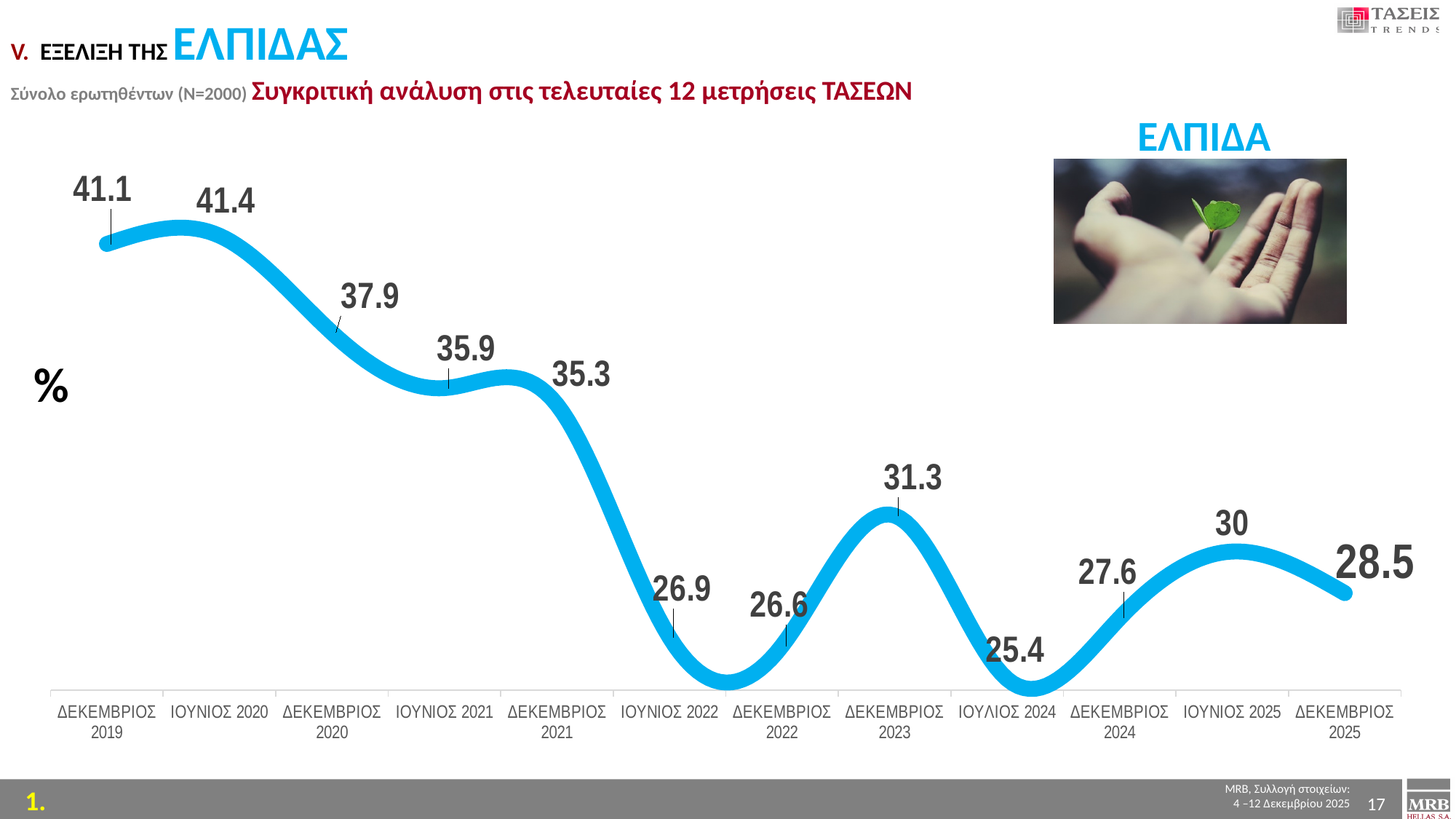
What is the difference between the values for ΔΕΚΕΜΒΡΙΟΣ 2019 and ΔΕΚΕΜΒΡΙΟΣ 2025? 12.6 Do the values generally rise or fall from ΔΕΚΕΜΒΡΙΟΣ 2019 to ΔΕΚΕΜΒΡΙΟΣ 2022? fall What is the value for ΔΕΚΕΜΒΡΙΟΣ 2025? 28.5 What is the value for ΙΟΥΝΙΟΣ 2022? 26.9 What is the difference between the values for ΙΟΥΝΙΟΣ 2025 and ΔΕΚΕΜΒΡΙΟΣ 2024? 2.4 Which measurement has the lowest value? ΙΟΥΛΙΟΣ 2024 What is the value for ΙΟΥΝΙΟΣ 2025? 30 Which measurement has the highest value? ΙΟΥΝΙΟΣ 2020 How many measurement points are plotted on the chart? 12 What is the value for ΔΕΚΕΜΒΡΙΟΣ 2023? 31.3 Which is larger, the value for ΔΕΚΕΜΒΡΙΟΣ 2020 or the value for ΔΕΚΕΜΒΡΙΟΣ 2021? ΔΕΚΕΜΒΡΙΟΣ 2020 What kind of chart is shown on the slide? line chart